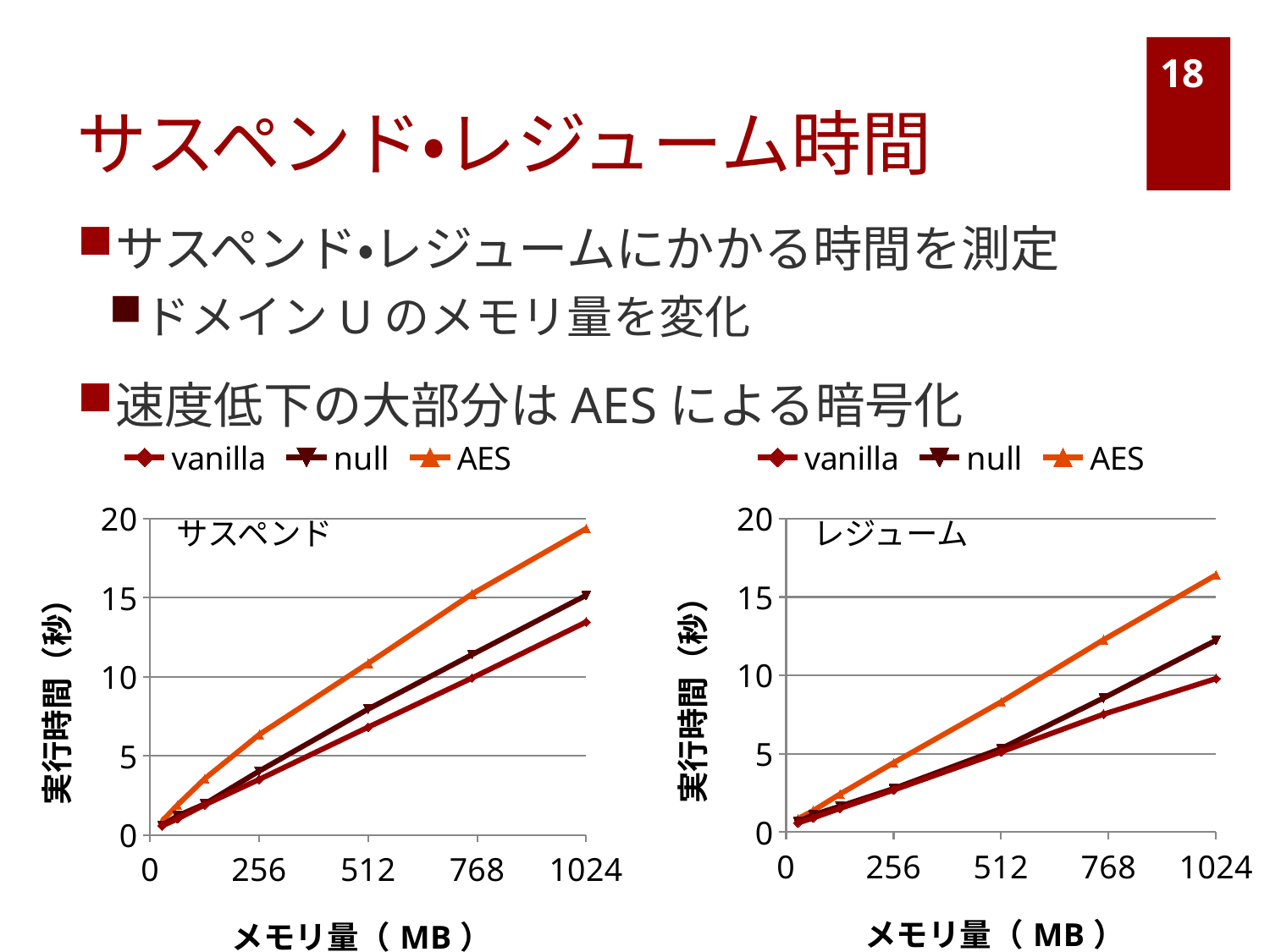
In the レジューム chart on the right, do the values for AES rise or fall as memory increases along the x axis? rise What kind of chart is the サスペンド chart on the left? line chart What is the label of the x axis on the サスペンド chart on the left? メモリ量（MB） In the サスペンド chart on the left, which is larger at 1024 MB: null or vanilla? null In the レジューム chart on the right, is the value for null at 1024 MB greater or less than 10? greater How many series does the legend of the レジューム chart on the right list? 3 In the サスペンド chart on the left, is the value for vanilla at 1024 MB greater or less than 15? less In the レジューム chart on the right, is the value for AES at 512 MB greater or less than 5? greater In the サスペンド chart on the left, which series has the highest value at 1024 MB? AES In the レジューム chart on the right, which series has the lowest value at 1024 MB? vanilla